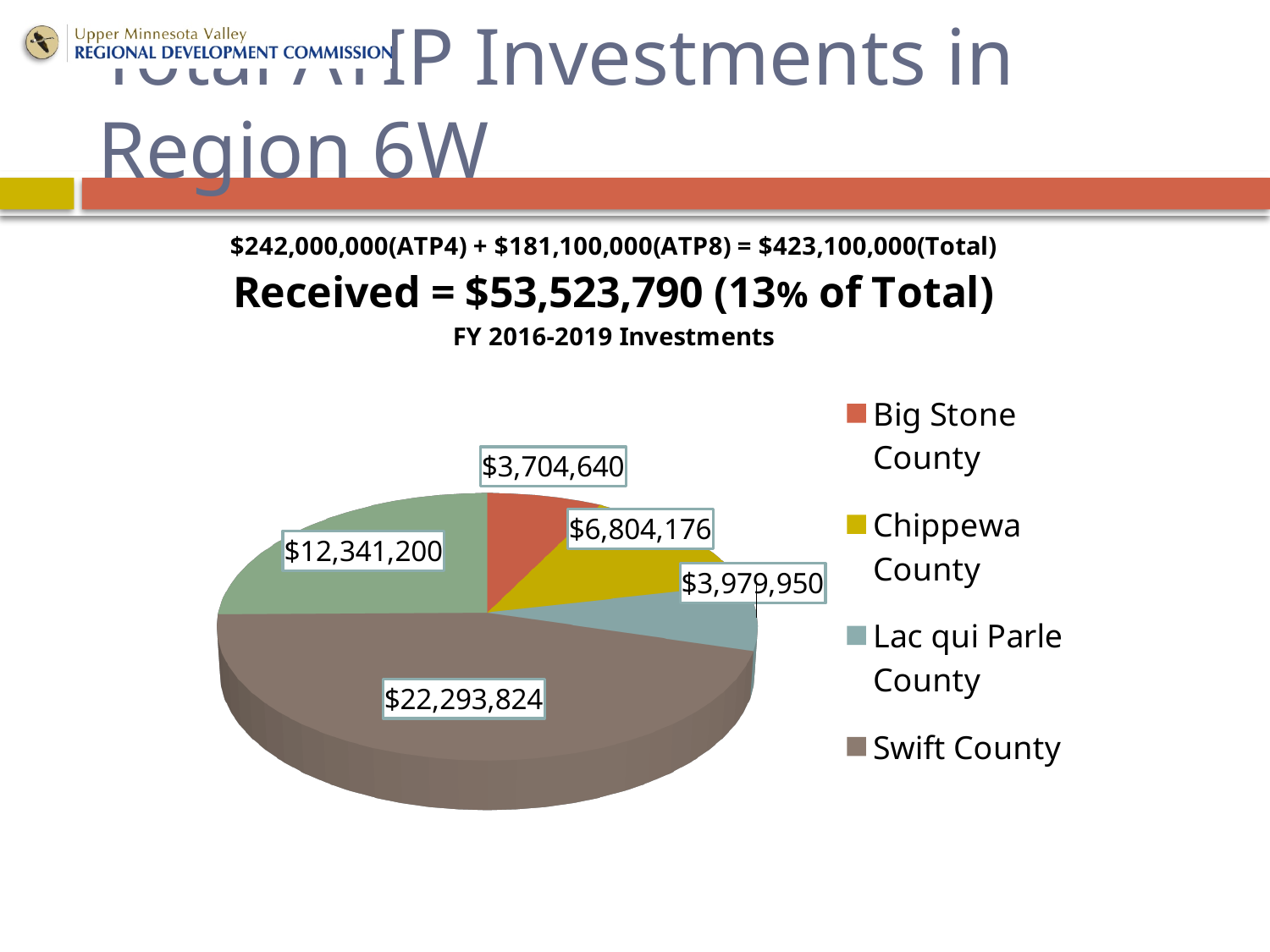
Which is larger, the value for Lac qui Parle County or the value for Big Stone County? Lac qui Parle County What is the value shown for Big Stone County? $3,704,640 Which county has the smallest value among the legend entries? Big Stone County What is the value shown for Lac qui Parle County? $3,979,950 What kind of chart is shown on the slide? pie chart What is the difference between the values for Chippewa County and Big Stone County? $3,099,536 What is the value shown for Chippewa County? $6,804,176 How many slices does the pie chart have? 5 What is the difference between the values for Swift County and Chippewa County? $15,489,648 What is the value shown for Swift County? $22,293,824 How many entries does the legend list? 4 Which county has the largest slice of the pie? Swift County